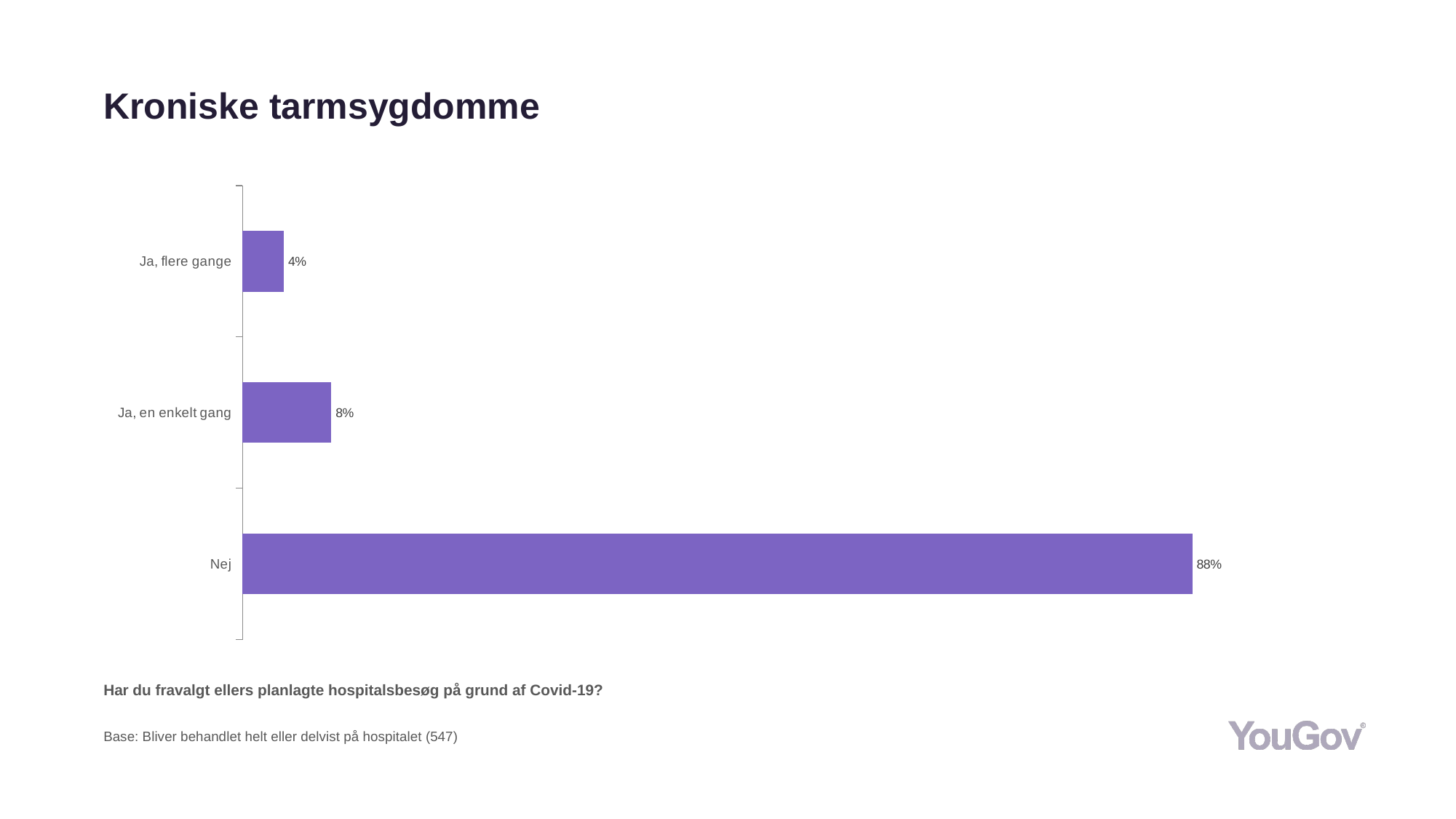
What is the value for "Ja, flere gange"? 4% What is the value for "Ja, en enkelt gang"? 8% Which category has the lowest value? Ja, flere gange How many categories are shown in the chart? 3 Which category has the highest value? Nej What is the value for "Nej"? 88% What is the difference between the values for "Ja, en enkelt gang" and "Ja, flere gange"? 4% What is the title of the slide? Kroniske tarmsygdomme What is the difference between the values for "Nej" and "Ja, en enkelt gang"? 80% What colour are the bars in the chart? Purple What kind of chart is shown on the slide? Bar chart Which is larger, the value for "Ja, en enkelt gang" or the value for "Ja, flere gange"? Ja, en enkelt gang